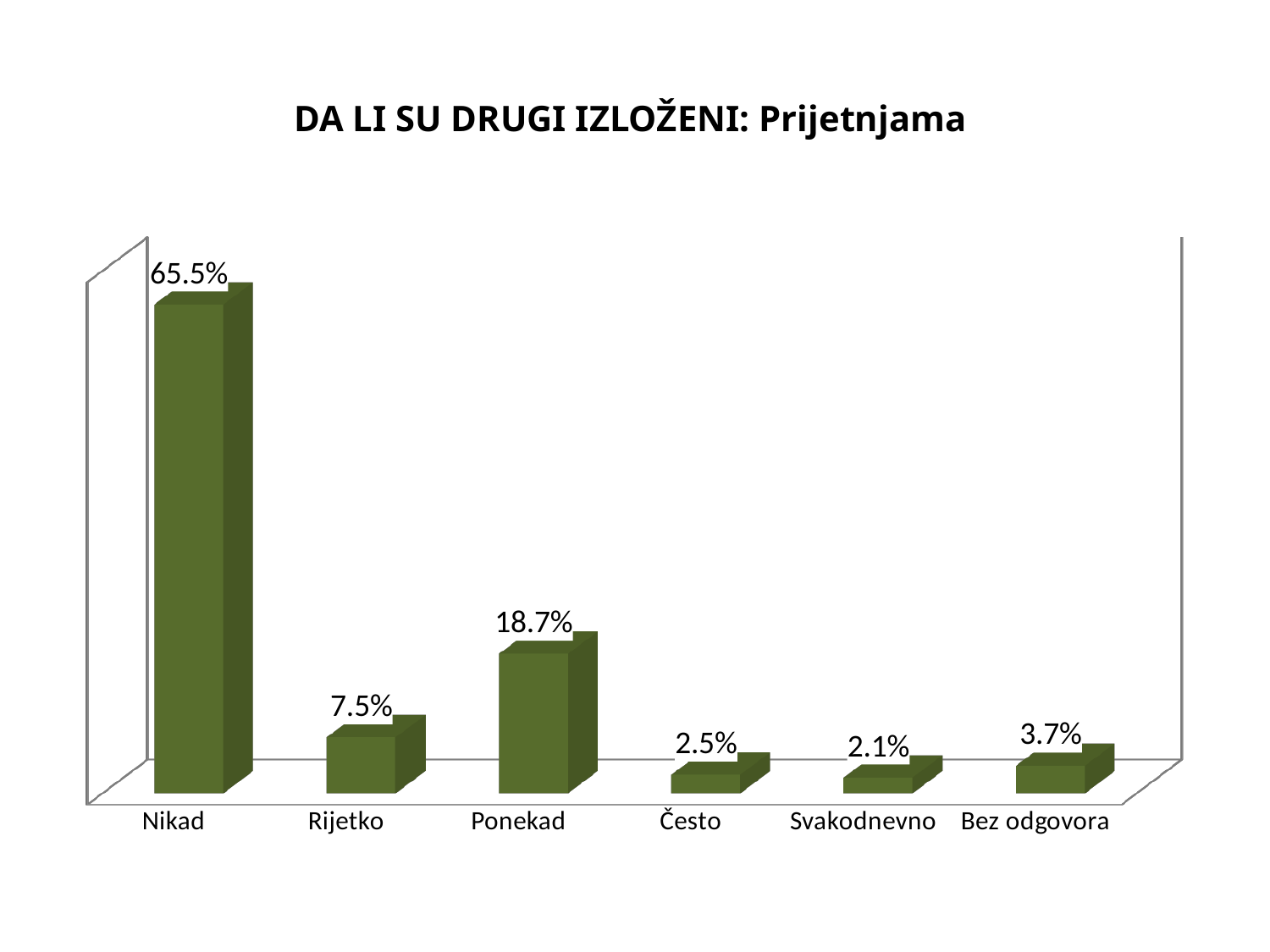
Which is larger, the value for Rijetko or the value for Bez odgovora? Rijetko What is the value for Ponekad? 18.7% Which category has the lowest value? Svakodnevno What is the value for Bez odgovora? 3.7% What is the value for Svakodnevno? 2.1% What is the difference between the values for Nikad and Ponekad? 46.8% What is the difference between the values for Rijetko and Često? 5.0% What is the title of the chart? DA LI SU DRUGI IZLOŽENI: Prijetnjama Which category has the highest value? Nikad How many categories are shown on the x axis? 6 What is the value for Nikad? 65.5% What kind of chart is this? Bar chart